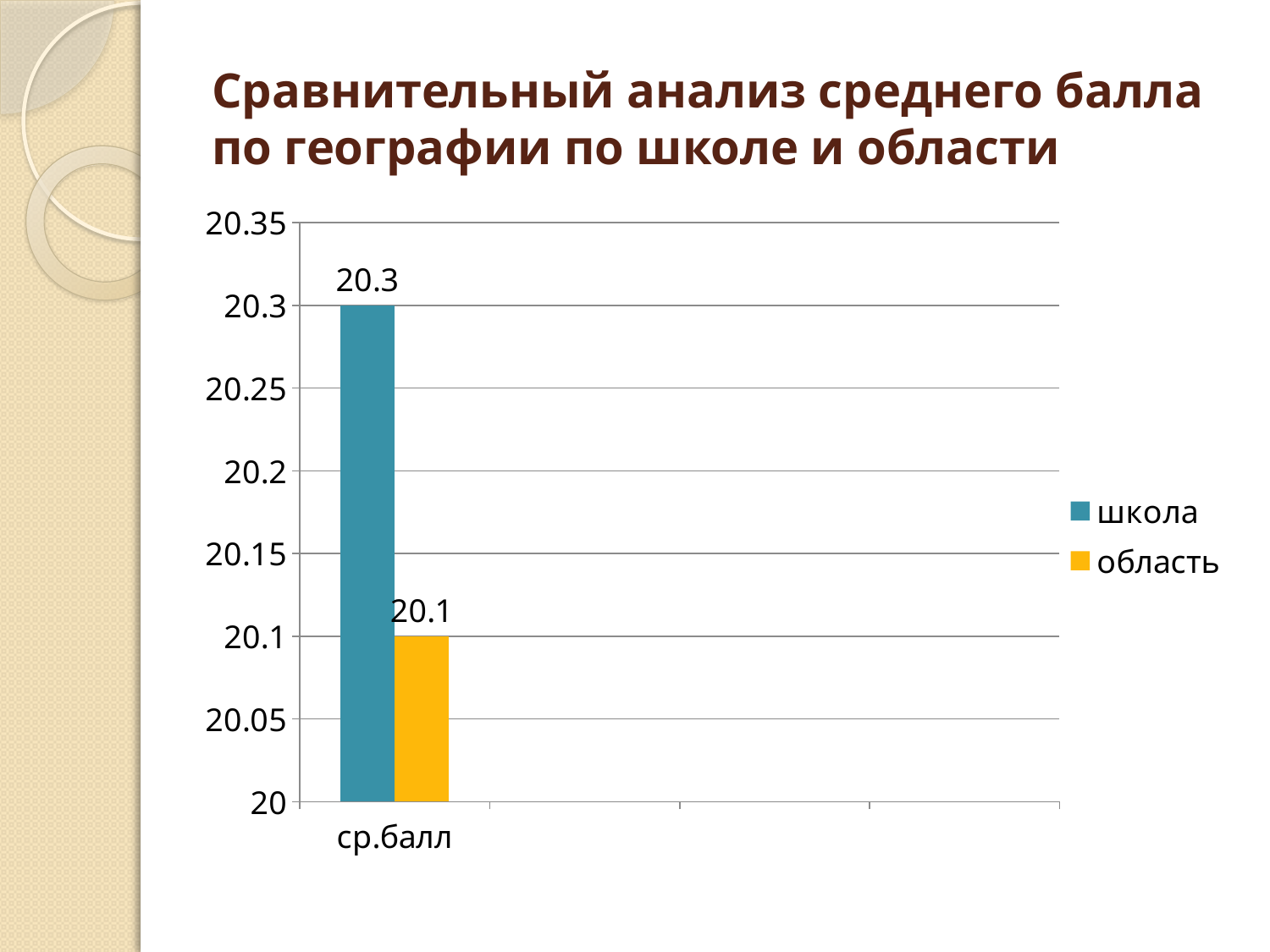
What kind of chart is shown on the slide? bar chart How many series does the legend list? 2 What is the difference between the школа value and the область value? 0.2 What is the label of the category on the x axis? ср.балл Is the value for область greater or less than 20.2? less What colour is the bar for школа? teal blue What is the value for область in the ср.балл category? 20.1 Which series has the higher value: школа or область? школа Is the value for школа greater or less than 20.25? greater Which series has the lowest value on the chart? область What is the value for школа in the ср.балл category? 20.3 How many categories are shown on the x axis? 1